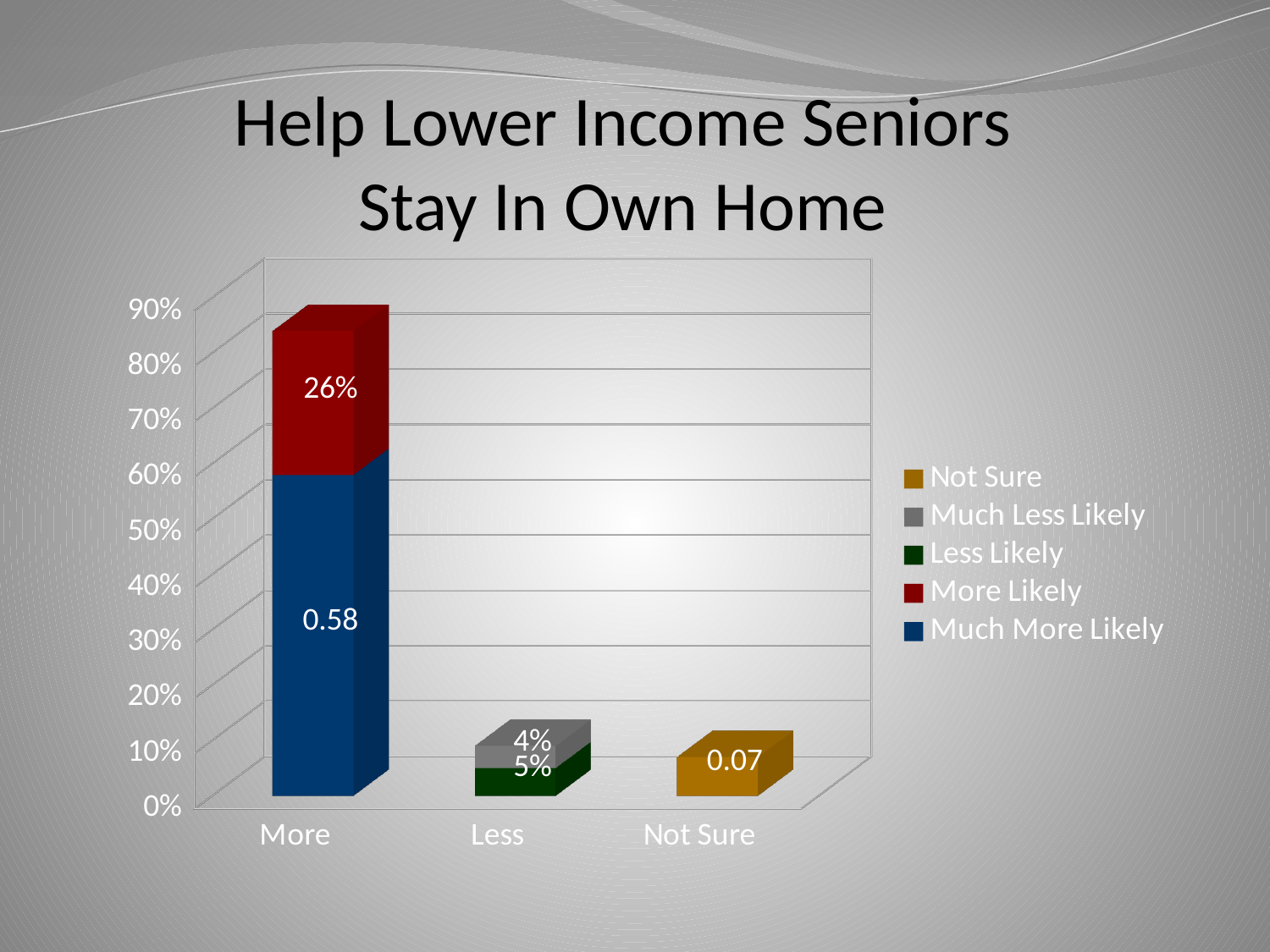
What is the value of the Less Likely segment in the Less bar? 5% What kind of chart is shown on the slide? Stacked bar chart Is the total height of the More bar greater or less than 80%? greater Which category has the tallest stacked bar? More What is the total of the Less stacked bar? 9% Which is larger, the Less Likely segment or the Much Less Likely segment in the Less bar? Less Likely How many series does the legend list? 5 What is the value of the More Likely segment in the More bar? 26% What is the data label shown for the Much More Likely segment of the More bar? 0.58 How many categories are shown on the x axis? 3 What is the value of the Much Less Likely segment in the Less bar? 4% What is the data label shown for the Not Sure bar? 0.07